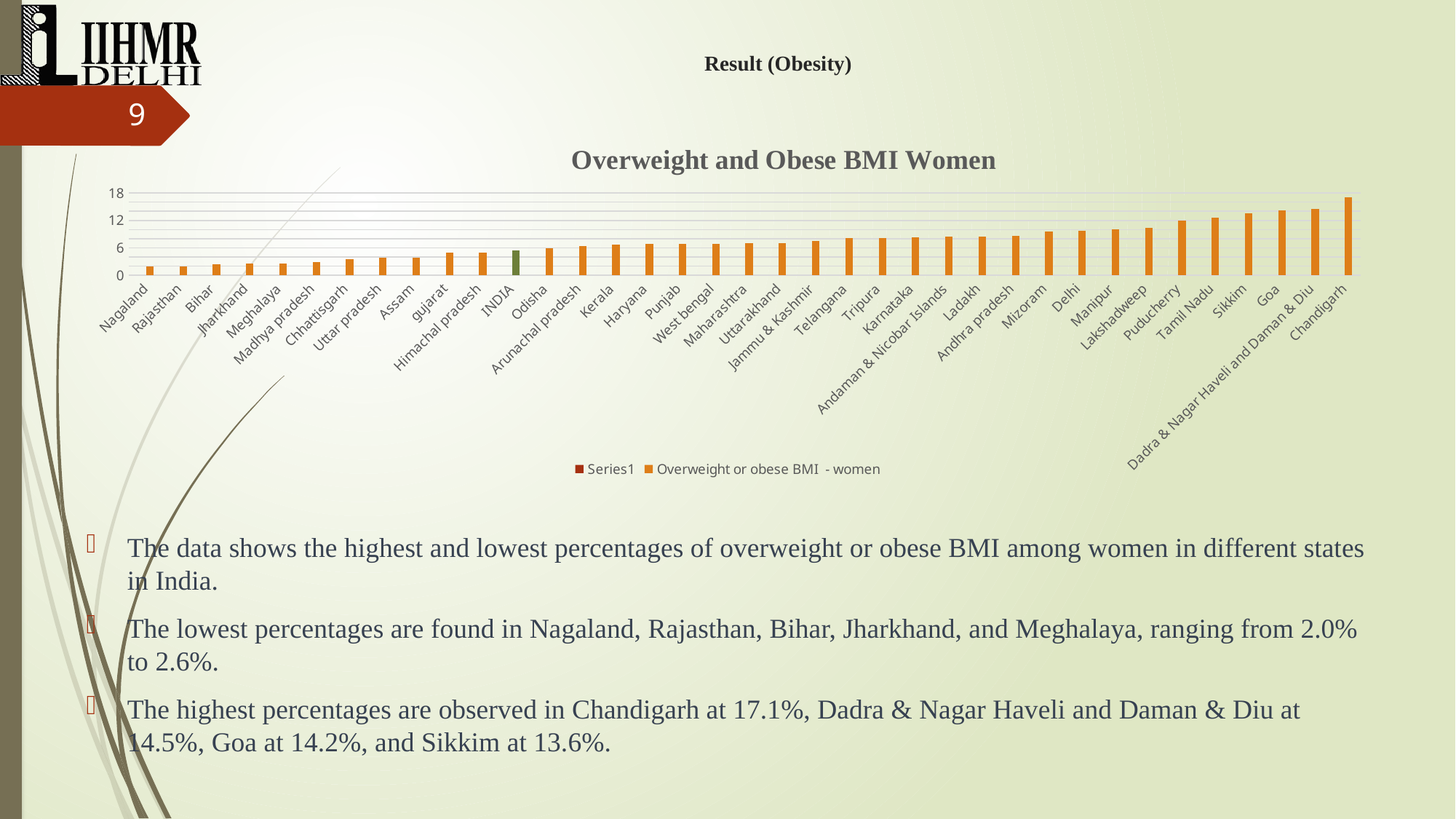
What kind of chart is shown on the slide? bar chart Is the value for Chandigarh greater or less than 12? greater Do the values generally rise or fall moving from left to right along the x axis? rise Is the value for Delhi greater or less than 6? greater What is the title of the chart? Overweight and Obese BMI Women Is the value for Sikkim greater or less than 12? greater Which category has the highest value in the chart? Chandigarh Which has the larger value, Goa or Kerala? Goa How many categories are plotted along the x axis? 37 Which bar is shown in a different colour (green) from the rest? INDIA How many series does the legend list? 2